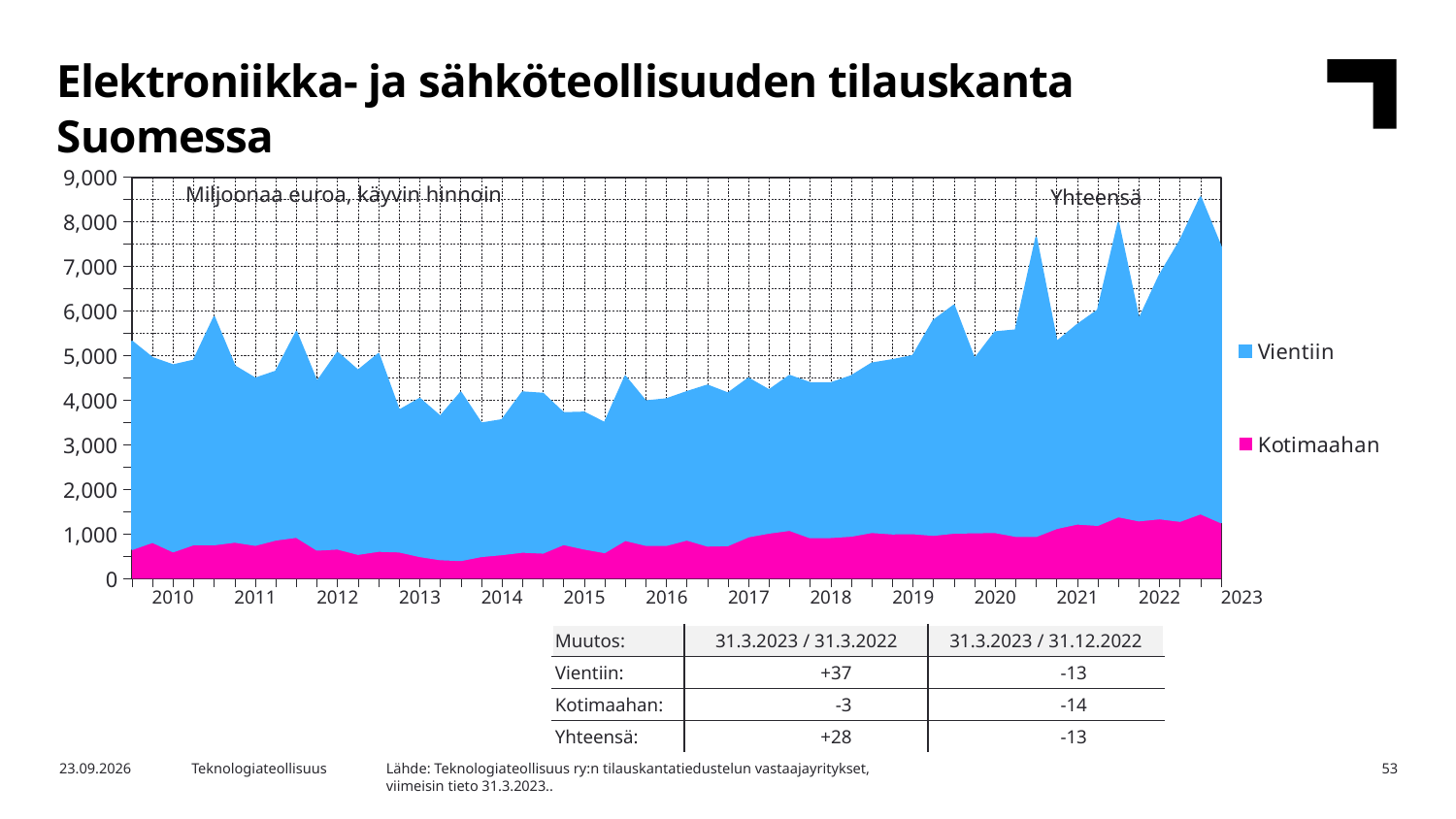
How many series does the legend list? 2 Is the total (Yhteensä) in 2014 greater or less than 5,000? less Is the value for Kotimaahan in 2010 greater or less than 1,000? less Which two series are listed in the chart legend? Vientiin and Kotimaahan Is the highest point of the total (Yhteensä) in 2022 greater or less than 8,000? greater What unit is stated on the chart for the values? Miljoonaa euroa, käyvin hinnoin How many year labels are shown on the x axis? 14 What kind of chart is shown on the slide? Area chart Does the total (Yhteensä) generally rise or fall from 2015 to 2023? Rise Which series is larger throughout the chart, Vientiin or Kotimaahan? Vientiin